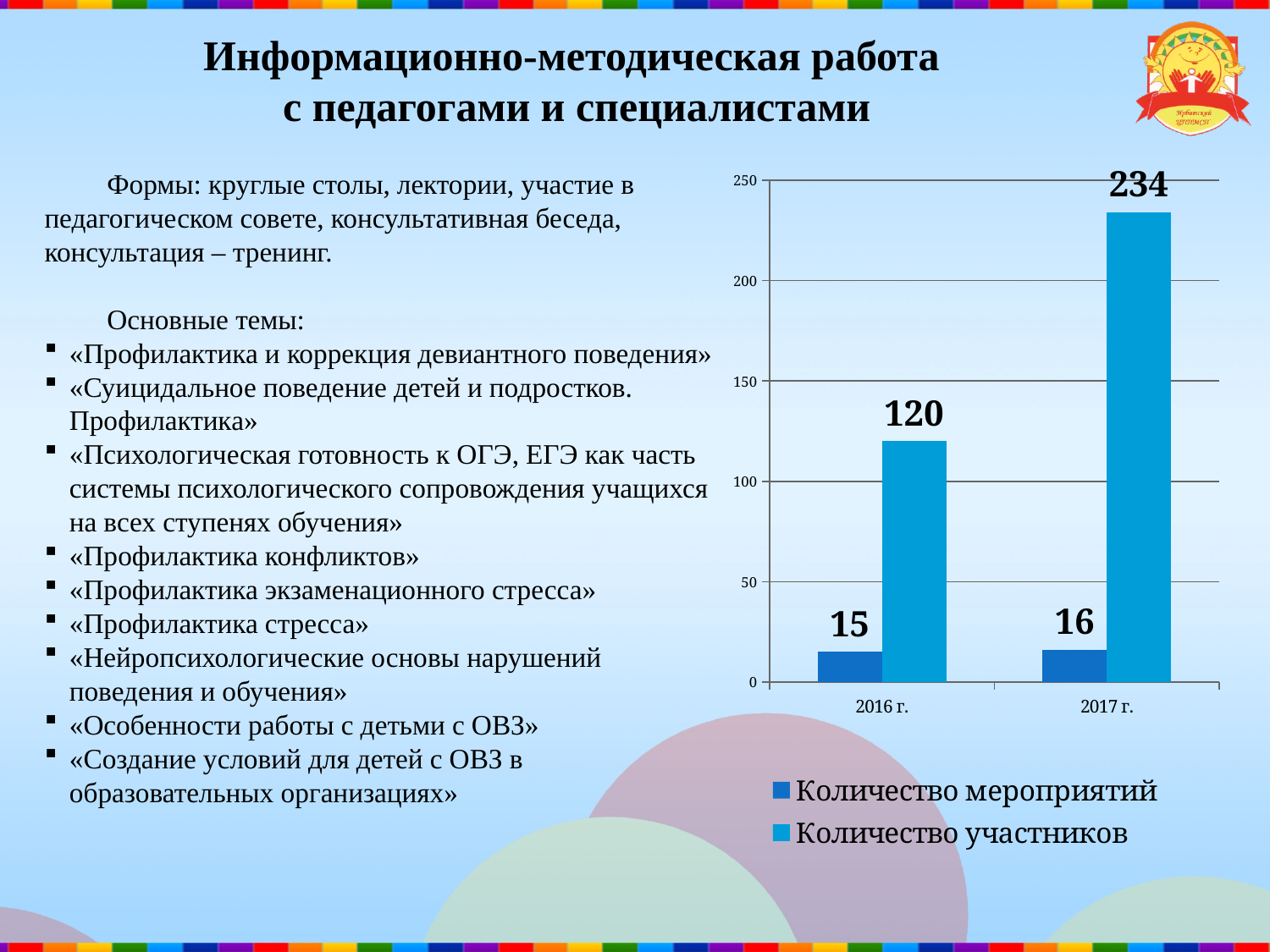
What is the value for Количество мероприятий in 2016 г.? 15 How many categories are shown on the x axis of the chart? 2 Is the value for Количество участников in 2017 г. greater or less than 200? greater In which year is Количество участников highest? 2017 г. What is the difference between Количество участников and Количество мероприятий in 2016 г.? 105 How many series does the legend list? 2 Which is larger in 2017 г.: Количество мероприятий or Количество участников? Количество участников What is the difference in Количество участников between 2017 г. and 2016 г.? 114 What is the value for Количество мероприятий in 2017 г.? 16 What is the value for Количество участников in 2017 г.? 234 What kind of chart is shown on the slide? bar chart What is the value for Количество участников in 2016 г.? 120